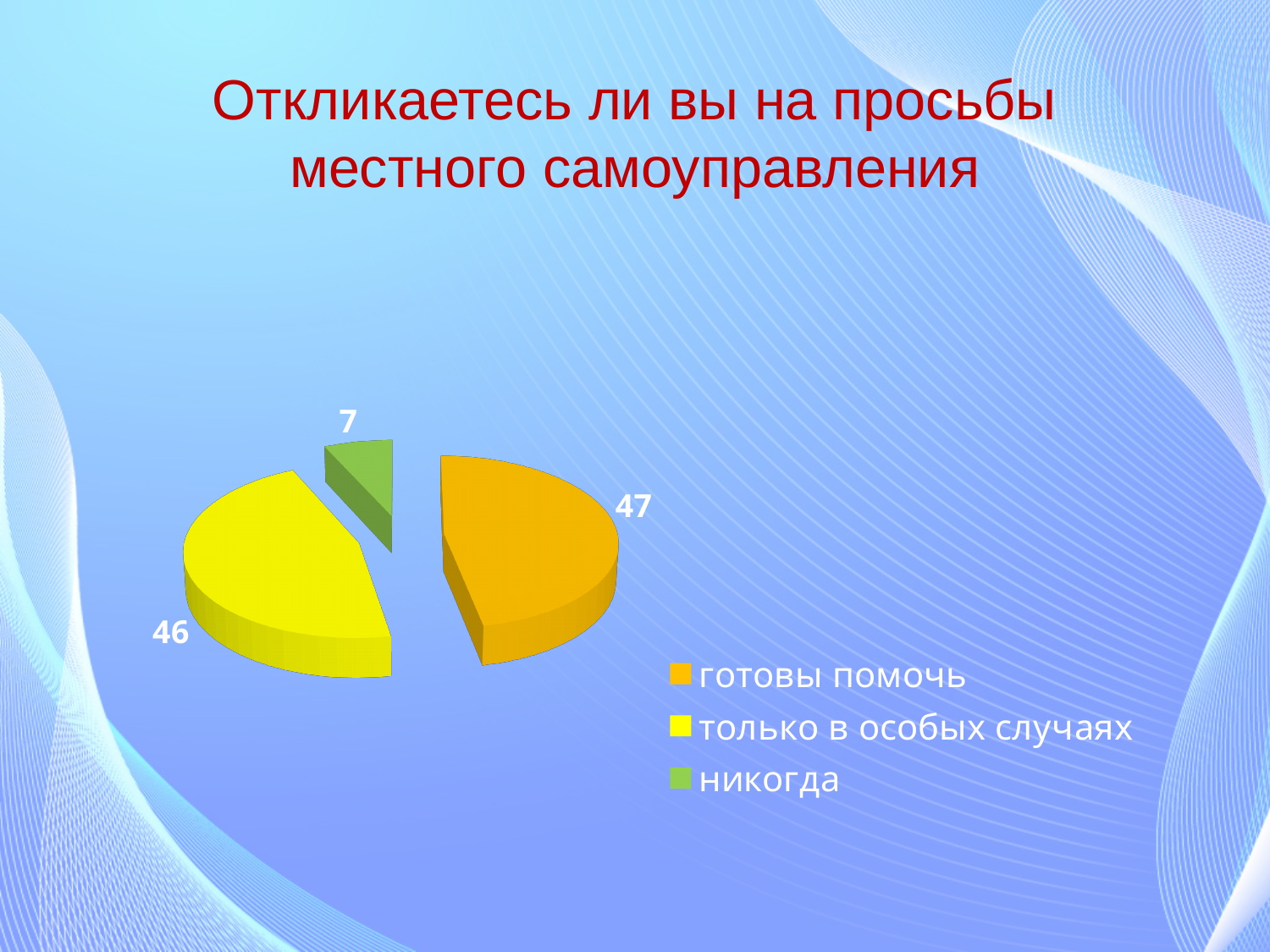
What is the total of all slices in the pie chart? 100 What is the value for "никогда"? 7 How many entries does the legend list? 3 What is the value for "только в особых случаях"? 46 What is the difference between the values for "готовы помочь" and "никогда"? 40 What is the value for "готовы помочь"? 47 Which category has the smallest slice? никогда Which is larger, the value for "только в особых случаях" or the value for "никогда"? только в особых случаях How many slices does the pie chart have? 3 What colour is the slice for "никогда"? green Which category has the largest slice? готовы помочь What type of chart is shown on the slide? pie chart